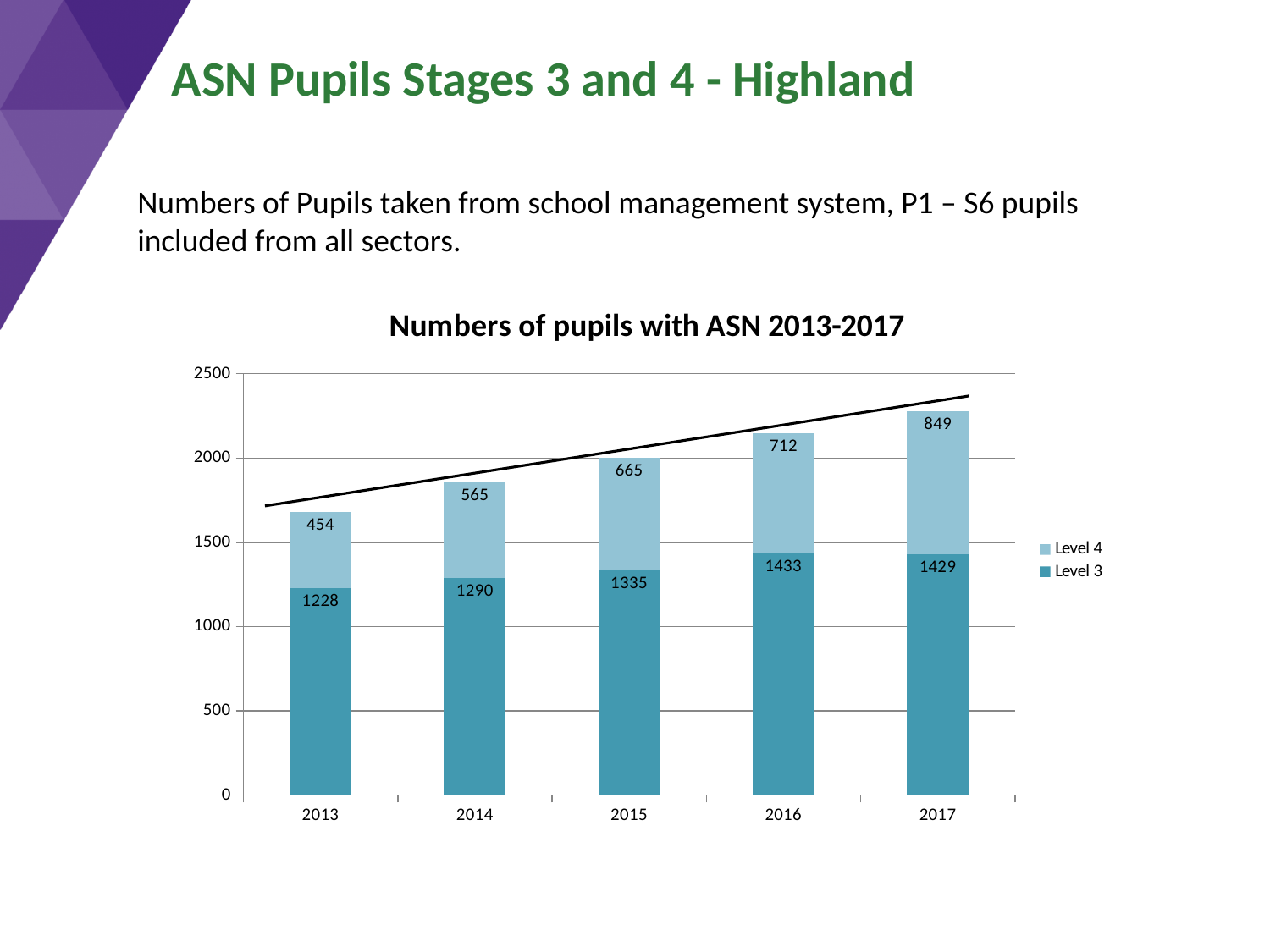
What is the Level 4 value for 2017? 849 Which year has the highest Level 4 value? 2017 Which is larger, the Level 3 value for 2016 or for 2017? 2016 Which year has the lowest Level 3 value? 2013 What kind of chart is shown? Stacked bar chart How many years are shown on the x axis? 5 What is the Level 3 value for 2015? 1335 Do the Level 4 values rise or fall from 2013 to 2017? Rise What is the difference between the Level 4 values for 2017 and 2013? 395 What is the Level 4 value for 2013? 454 How many series does the legend list? 2 What is the total of the stacked bar for 2016? 2145